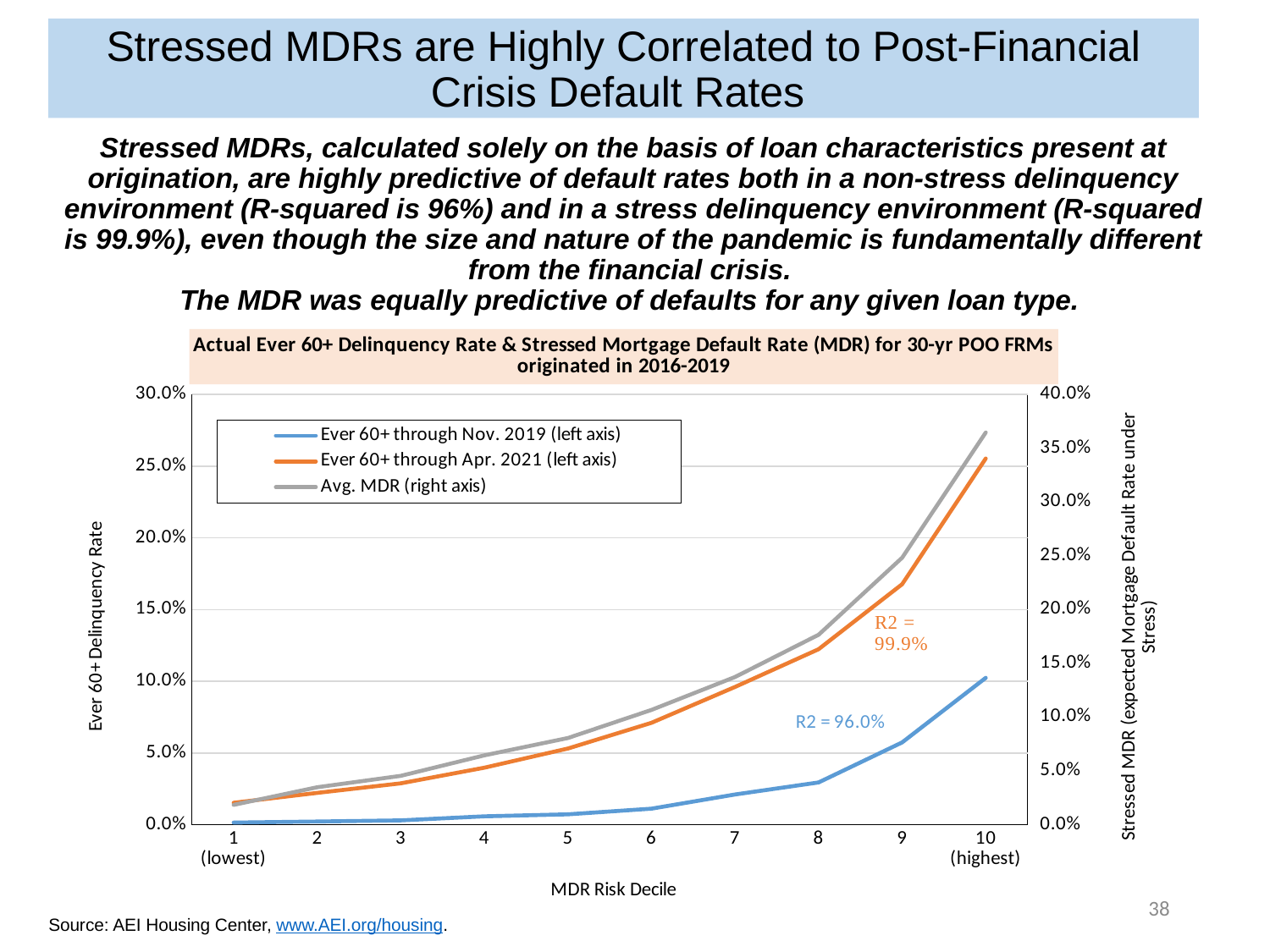
Is the value for Ever 60+ through Apr. 2021 at decile 10 greater or less than 20.0%? greater Which MDR risk decile has the highest value for Ever 60+ through Apr. 2021? 10 (highest) Is the value for Avg. MDR (right axis) at decile 10 greater or less than 30.0%? greater How many MDR risk deciles are plotted along the x axis? 10 What R-squared value is annotated next to the Ever 60+ through Nov. 2019 line? R2 = 96.0% Is the value for Ever 60+ through Nov. 2019 at decile 8 greater or less than 5.0%? less What is the label of the chart's x axis? MDR Risk Decile At decile 10, which is larger: Ever 60+ through Nov. 2019 or Ever 60+ through Apr. 2021? Ever 60+ through Apr. 2021 How many series does the chart's legend list? 3 Which MDR risk decile has the lowest value for Ever 60+ through Nov. 2019? 1 (lowest) What kind of chart is shown on the slide? Line chart Do the values for Avg. MDR (right axis) rise or fall as the MDR risk decile increases from 1 to 10? Rise